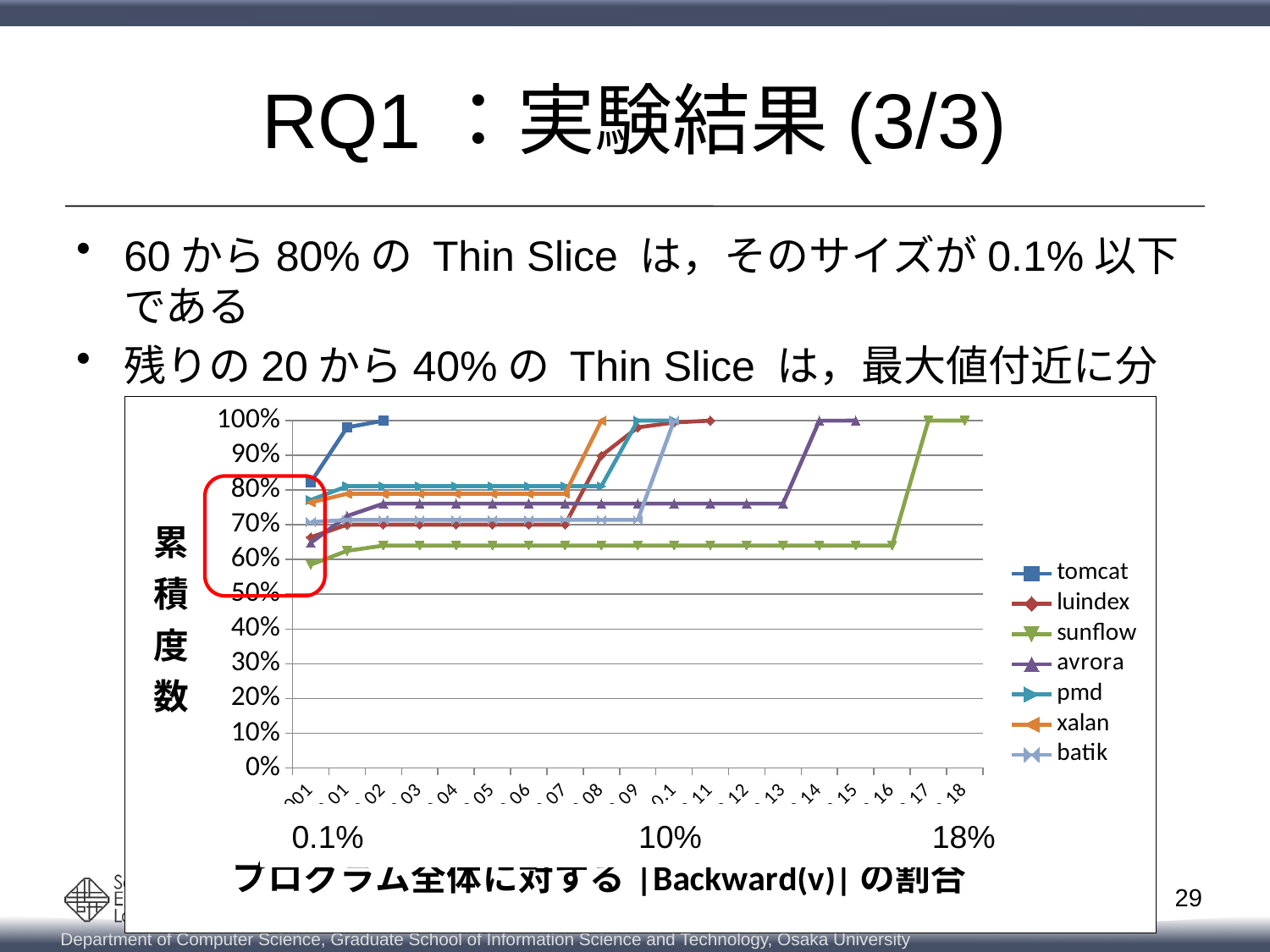
What kind of chart is shown on the slide? line chart What value does the tomcat series reach at its final plotted point? 100% Is the value of the sunflow series at the 0.1 point on the x axis greater or less than 70%? less What is the label on the vertical axis of the chart? 累積度数 How many series does the chart's legend list? 7 Do the values of each series rise or fall as you move along the x axis? rise Which series is the last to reach 100% along the x axis? sunflow Is the value of the avrora series at the 0.1 point on the x axis greater or less than 80%? less Which series is listed first in the chart's legend? tomcat At the 0.05 point on the x axis, which series has the larger value, pmd or sunflow? pmd Which series has the lowest value at the leftmost point of the chart? sunflow Which series is the first to reach 100% along the x axis? tomcat